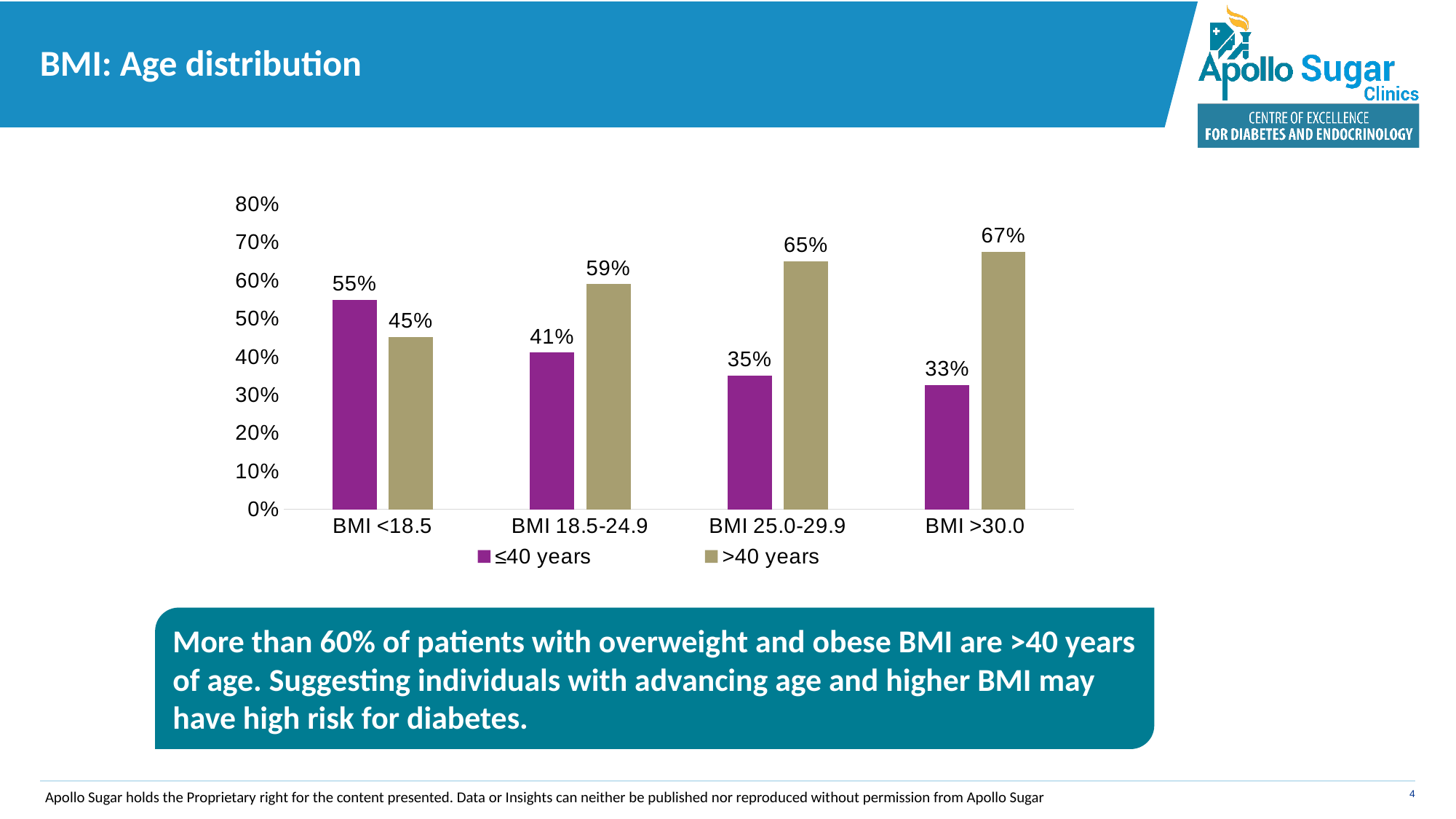
What colour are the bars for the >40 years series? Tan/khaki What is the difference between the >40 years and ≤40 years values in the BMI 18.5-24.9 category? 18% What kind of chart is shown on the slide? Bar chart In the BMI <18.5 category, which is larger: ≤40 years or >40 years? ≤40 years Which BMI category has the highest value for >40 years? BMI >30.0 Which BMI category has the lowest value for ≤40 years? BMI >30.0 What is the value for ≤40 years in the BMI <18.5 category? 55% What is the value for ≤40 years in the BMI >30.0 category? 33% How many BMI categories are shown on the x axis? 4 Do the ≤40 years values rise or fall as BMI increases along the x axis? Fall How many series does the legend list? 2 What is the value for >40 years in the BMI 25.0-29.9 category? 65%